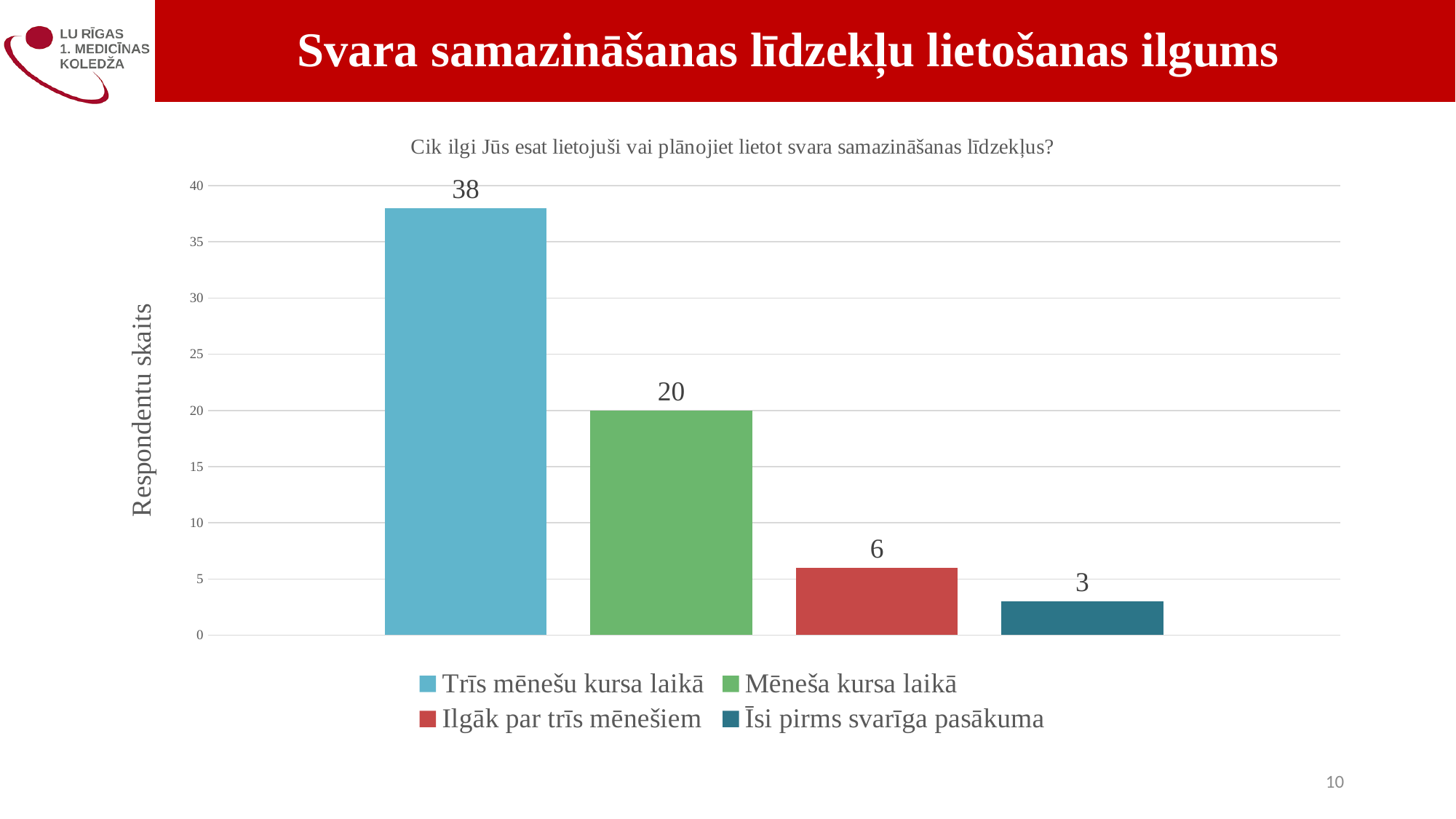
How many categories are shown in the chart? 4 What is the value for "Trīs mēnešu kursa laikā"? 38 What is the label of the vertical axis? Respondentu skaits Which category has the lowest value? Īsi pirms svarīga pasākuma How many entries does the legend list? 4 Which category has the highest value? Trīs mēnešu kursa laikā Which is larger, the value for "Ilgāk par trīs mēnešiem" or for "Īsi pirms svarīga pasākuma"? Ilgāk par trīs mēnešiem What kind of chart is shown on the slide? Bar chart What is the value for "Īsi pirms svarīga pasākuma"? 3 What is the value for "Mēneša kursa laikā"? 20 What is the difference between the values for "Trīs mēnešu kursa laikā" and "Mēneša kursa laikā"? 18 What is the value for "Ilgāk par trīs mēnešiem"? 6